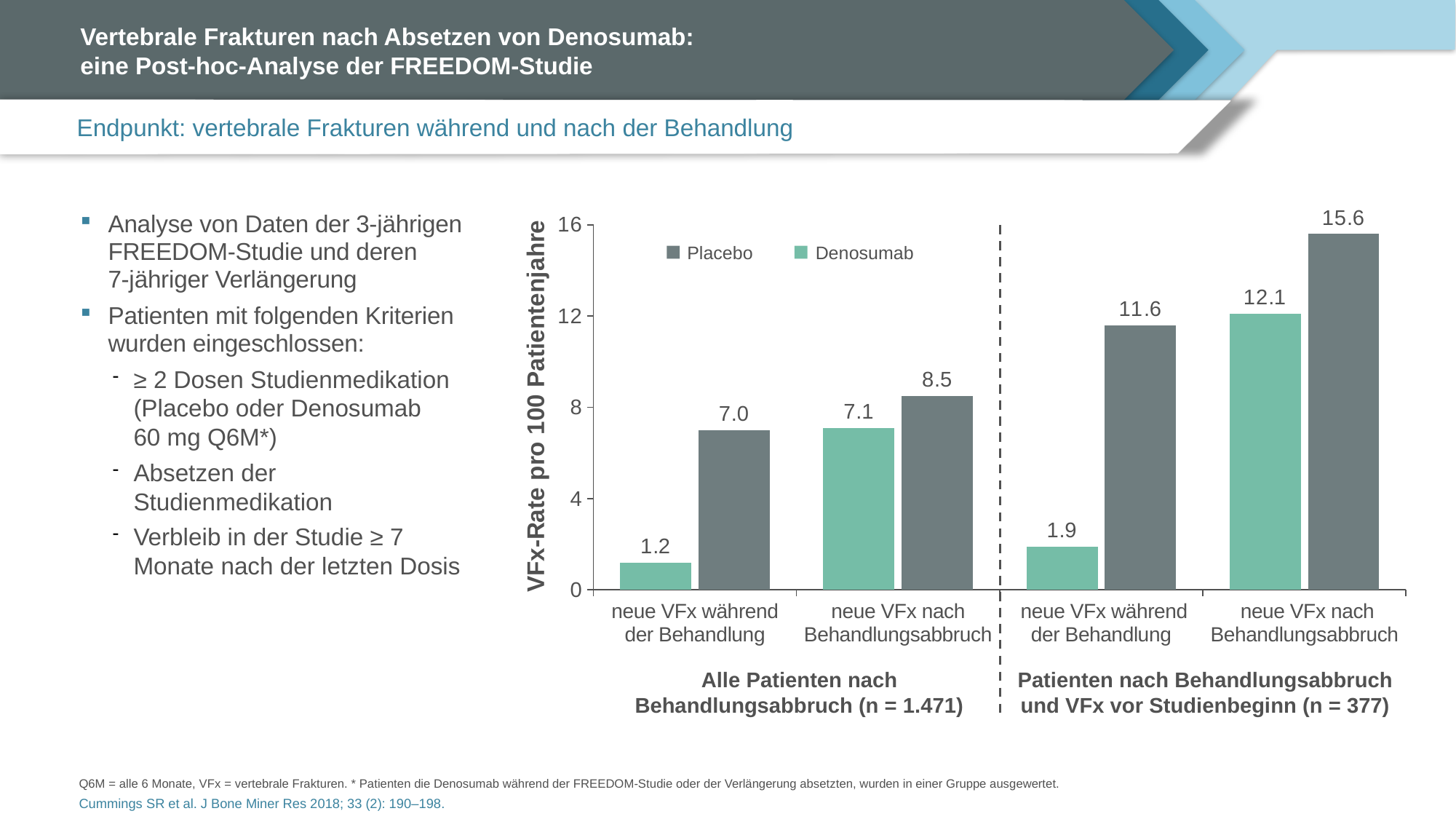
What is the label of the y axis of the chart? VFx-Rate pro 100 Patientenjahre In the group 'Patienten nach Behandlungsabbruch und VFx vor Studienbeginn (n = 377)', which is larger for 'neue VFx nach Behandlungsabbruch': Placebo or Denosumab? Placebo What type of chart is shown on the slide? bar chart What is the Denosumab VFx rate for 'neue VFx während der Behandlung' in the group 'Alle Patienten nach Behandlungsabbruch (n = 1.471)'? 1.2 What is the Placebo VFx rate for 'neue VFx während der Behandlung' in the group 'Patienten nach Behandlungsabbruch und VFx vor Studienbeginn (n = 377)'? 11.6 What is the difference between the Placebo and Denosumab VFx rates for 'neue VFx während der Behandlung' in the group 'Alle Patienten nach Behandlungsabbruch (n = 1.471)'? 5.8 How many series does the chart legend list? 2 Is the Denosumab VFx rate for 'neue VFx nach Behandlungsabbruch' in the n = 377 group greater or less than 8? greater What is the Placebo VFx rate for 'neue VFx nach Behandlungsabbruch' in the group 'Patienten nach Behandlungsabbruch und VFx vor Studienbeginn (n = 377)'? 15.6 Which bar in the chart has the highest VFx rate? Placebo, neue VFx nach Behandlungsabbruch (n = 377 group) What is the Denosumab VFx rate for 'neue VFx nach Behandlungsabbruch' in the group 'Alle Patienten nach Behandlungsabbruch (n = 1.471)'? 7.1 Which bar in the chart has the lowest VFx rate? Denosumab, neue VFx während der Behandlung (n = 1.471 group)